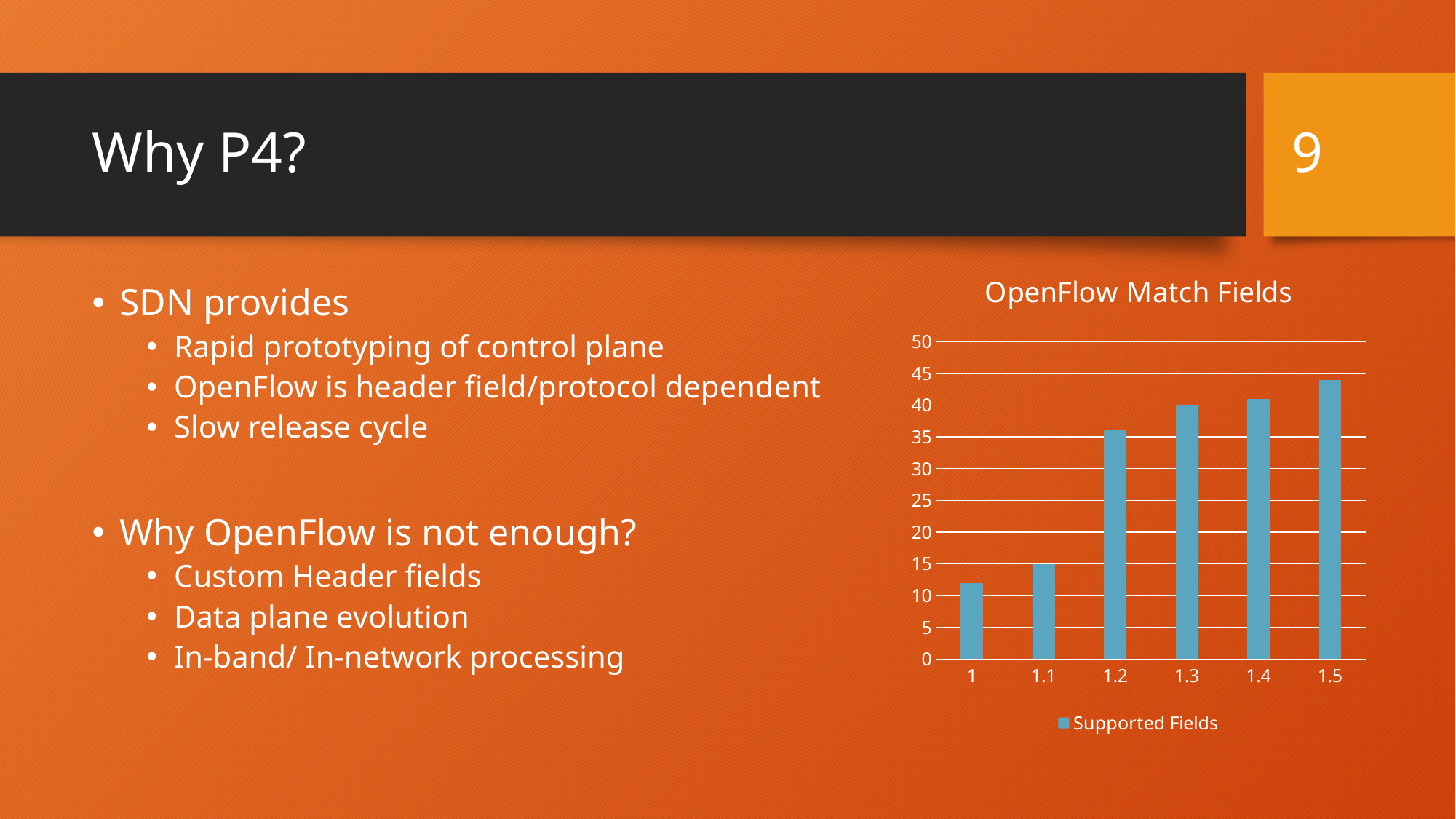
Which category has the highest value in the chart? 1.5 What kind of chart is shown on the slide? bar chart How many categories are shown on the x axis of the chart? 6 What is the name of the series shown in the chart's legend? Supported Fields Which has a larger value, 1.1 or 1.2? 1.2 Is the value for 1.2 greater or less than 30? greater Which category has the lowest value in the chart? 1 Do the values rise or fall from left to right along the x axis? rise How many series does the chart's legend list? 1 Is the value for 1.5 greater or less than 40? greater What is the title of the chart? OpenFlow Match Fields Is the value for 1 greater or less than 15? less